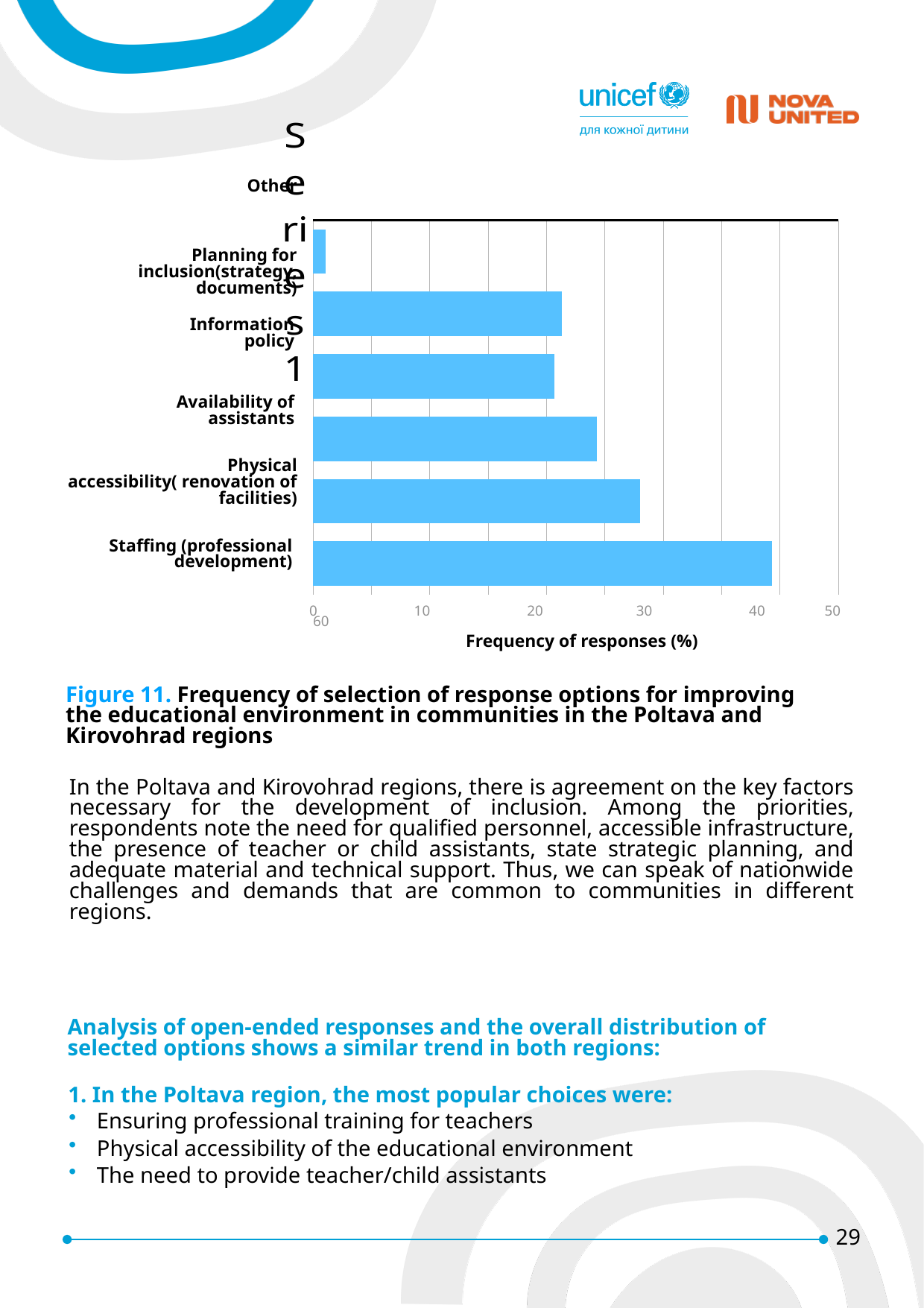
Is the value for Staffing (professional development) greater or less than 30? greater Which is larger: the value for Staffing (professional development) or for Physical accessibility (renovation of facilities)? Staffing (professional development) Which category has the lowest frequency of responses? Other Is the value for Physical accessibility (renovation of facilities) greater or less than 20? greater What kind of chart is shown on the slide? bar chart Which is larger: the value for Physical accessibility (renovation of facilities) or for Availability of assistants? Physical accessibility (renovation of facilities) How many categories are plotted in the chart? 6 What is the title of the horizontal axis? Frequency of responses (%) Is the value for Availability of assistants greater or less than 20? greater Which category has the highest frequency of responses? Staffing (professional development)